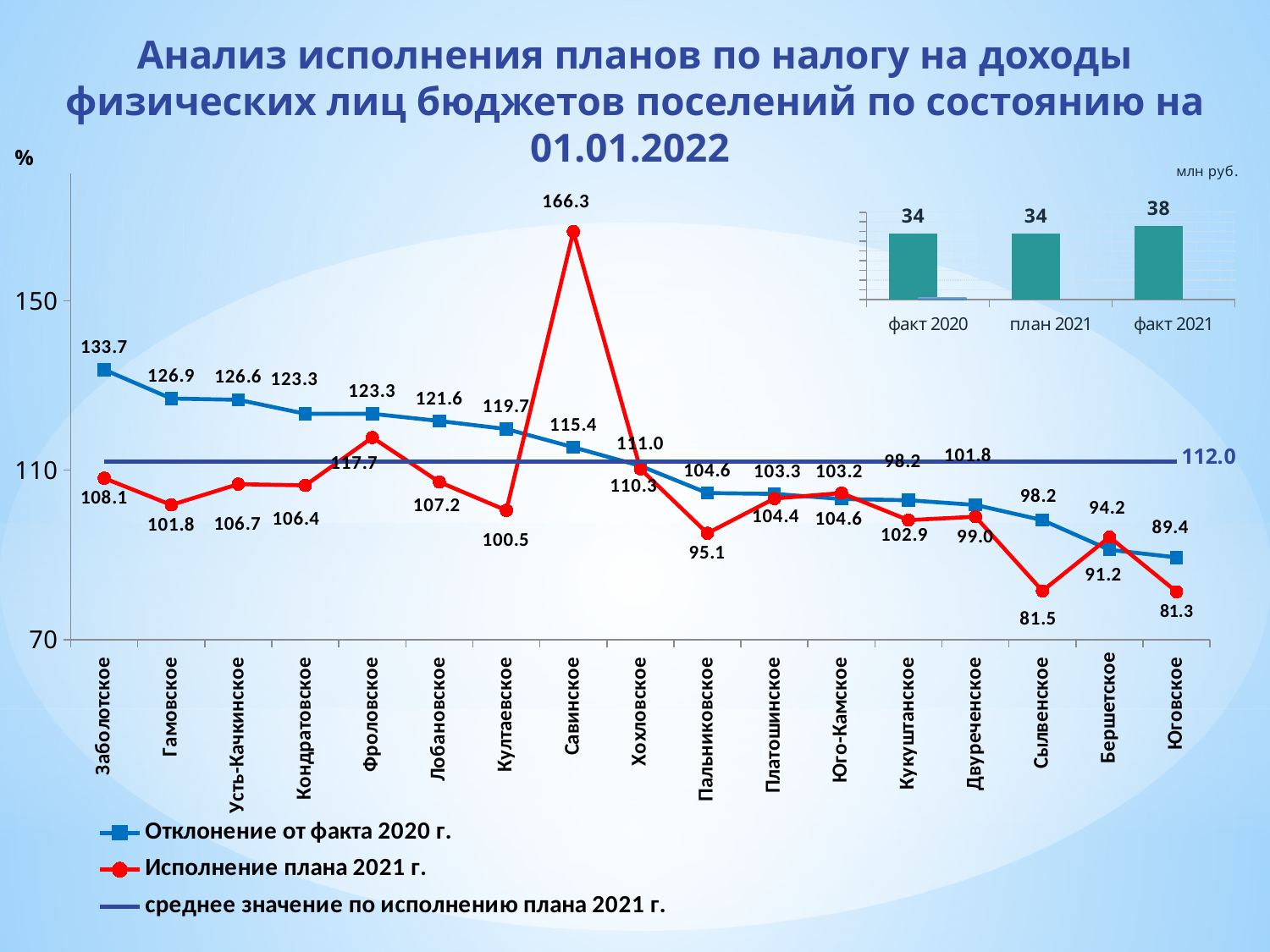
On the main line chart, what is the value of 'Отклонение от факта 2020 г.' for Заболотское? 133.7 On the main line chart, what is the value of 'Исполнение плана 2021 г.' for Савинское? 166.3 How many settlements are shown on the x axis of the main line chart? 17 On the small bar chart in the top right, what is the value for 'факт 2021'? 38 On the main line chart, which settlement has the highest value for 'Исполнение плана 2021 г.'? Савинское On the main line chart, what is the value of the 'среднее значение по исполнению плана 2021 г.' line? 112.0 On the main line chart, what is the difference between 'Отклонение от факта 2020 г.' and 'Исполнение плана 2021 г.' for Заболотское? 25.6 On the main line chart, does 'Отклонение от факта 2020 г.' generally rise or fall from left to right? fall On the main line chart, which settlement has the lowest value for 'Отклонение от факта 2020 г.'? Юговское On the main line chart, for Юговское, which is larger: 'Отклонение от факта 2020 г.' or 'Исполнение плана 2021 г.'? Отклонение от факта 2020 г. How many series does the legend of the main line chart list? 3 On the main line chart, is the 'Исполнение плана 2021 г.' value for Савинское greater or less than 150? greater